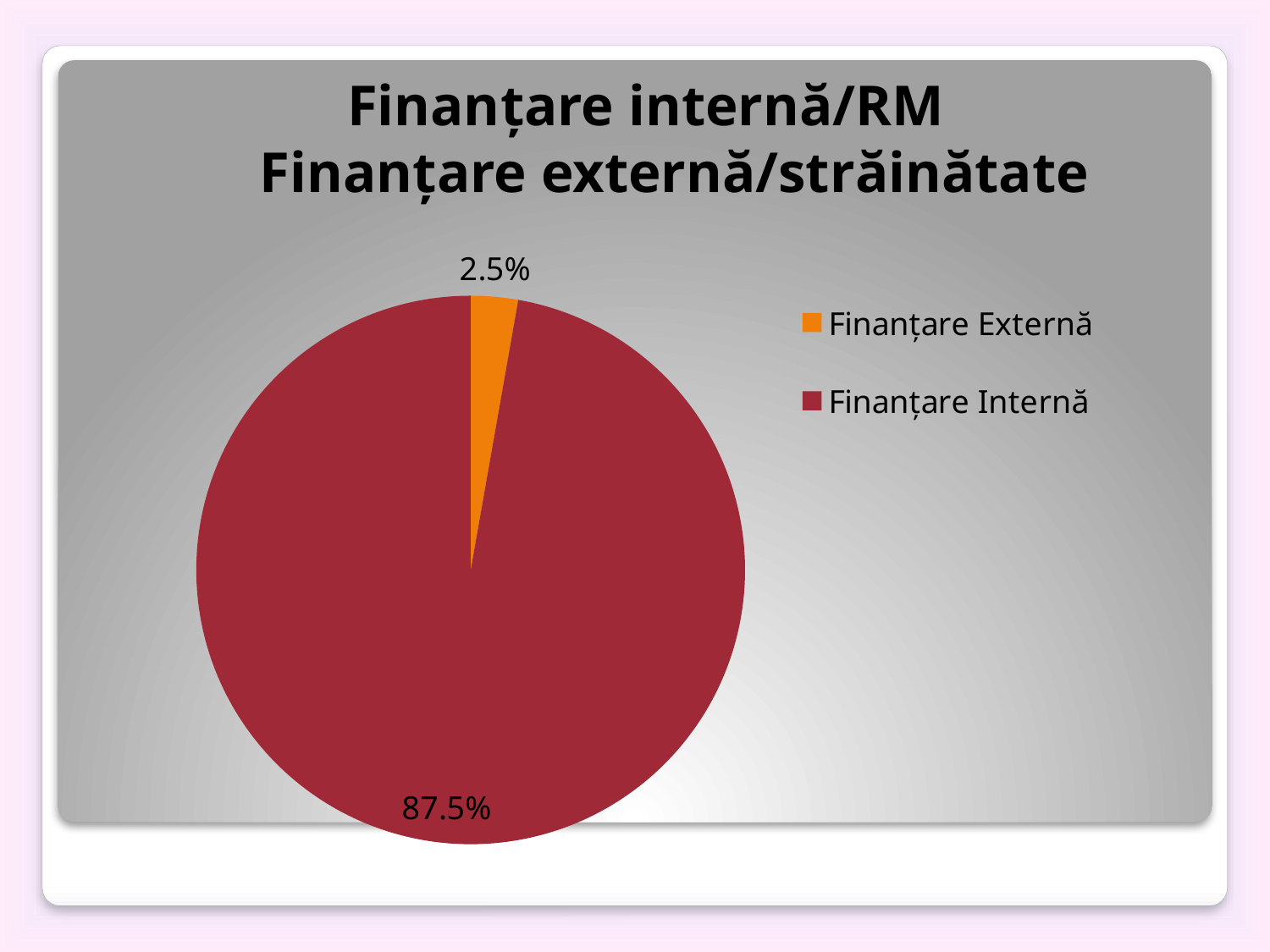
What percentage is shown for Finanțare Internă in the pie chart? 87.5% What colour is the Finanțare Externă slice in the pie chart? Orange What kind of chart is shown on the slide? Pie chart What is the title of the chart? Finanțare internă/RM Finanțare externă/străinătate What share of the pie is labelled for Finanțare Externă? 2.5% Which slice of the pie chart is the largest? Finanțare Internă Which slice of the pie chart is the smallest? Finanțare Externă Which is larger, Finanțare Internă or Finanțare Externă? Finanțare Internă What is the difference in percentage points between Finanțare Internă and Finanțare Externă? 85 percentage points What percentage is shown for Finanțare Externă in the pie chart? 2.5% How many entries does the legend list? 2 How many slices does the pie chart have? 2